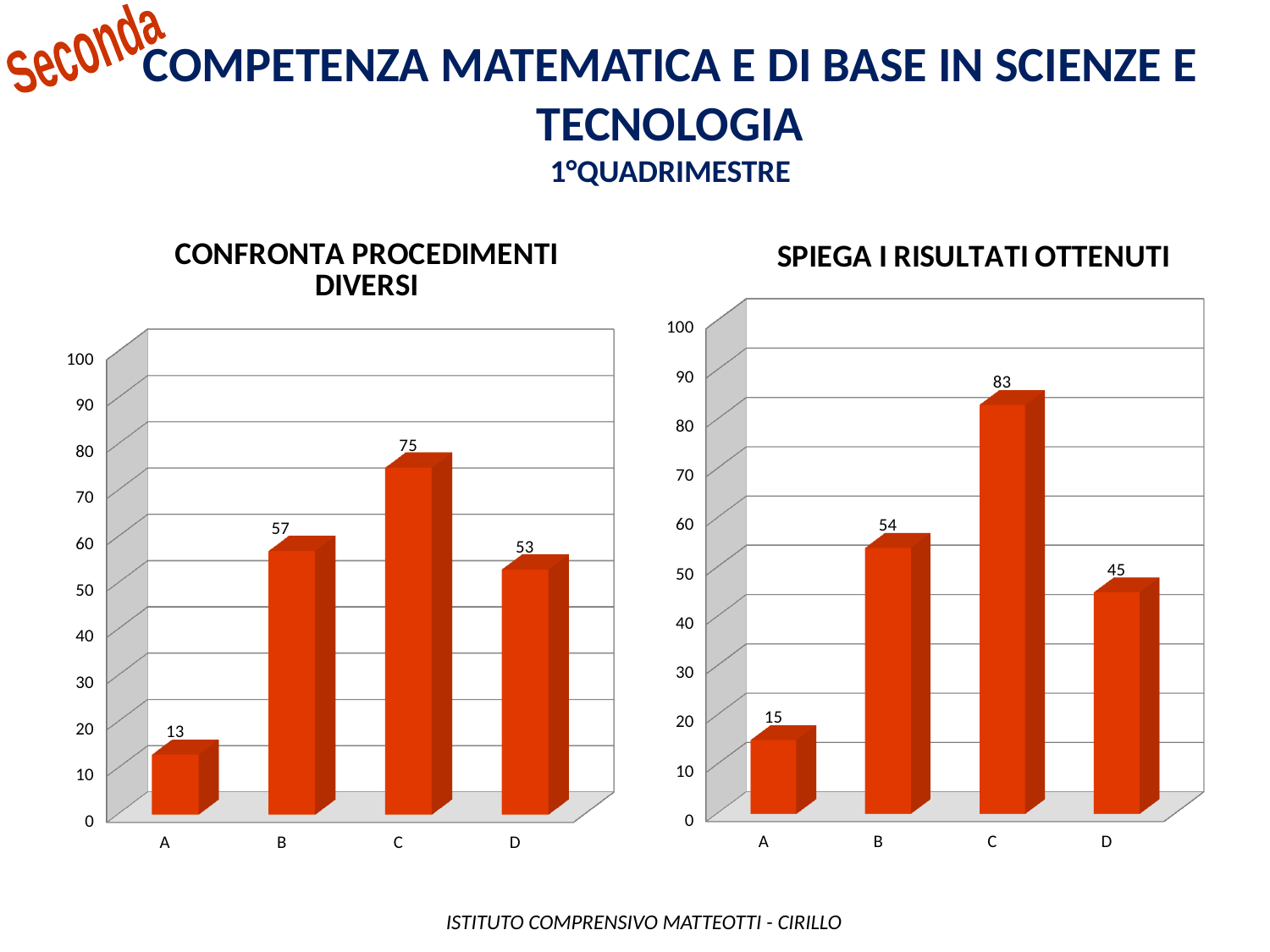
In the 'CONFRONTA PROCEDIMENTI DIVERSI' chart, is the value for D greater or less than 50? greater What kind of chart is the 'CONFRONTA PROCEDIMENTI DIVERSI' chart? Bar chart In the 'SPIEGA I RISULTATI OTTENUTI' chart, what is the difference between the values for C and D? 38 In the 'SPIEGA I RISULTATI OTTENUTI' chart, what is the value for category A? 15 How many categories are shown in the 'SPIEGA I RISULTATI OTTENUTI' chart? 4 What is the title of the chart on the right side of the slide? SPIEGA I RISULTATI OTTENUTI In the 'CONFRONTA PROCEDIMENTI DIVERSI' chart, what is the difference between the values for B and D? 4 In the 'CONFRONTA PROCEDIMENTI DIVERSI' chart, what is the value for category B? 57 In the 'SPIEGA I RISULTATI OTTENUTI' chart, which category has the highest value? C In the 'SPIEGA I RISULTATI OTTENUTI' chart, which is larger, the value for B or the value for D? B In the 'CONFRONTA PROCEDIMENTI DIVERSI' chart, what is the value for category C? 75 In the 'CONFRONTA PROCEDIMENTI DIVERSI' chart, which category has the lowest value? A